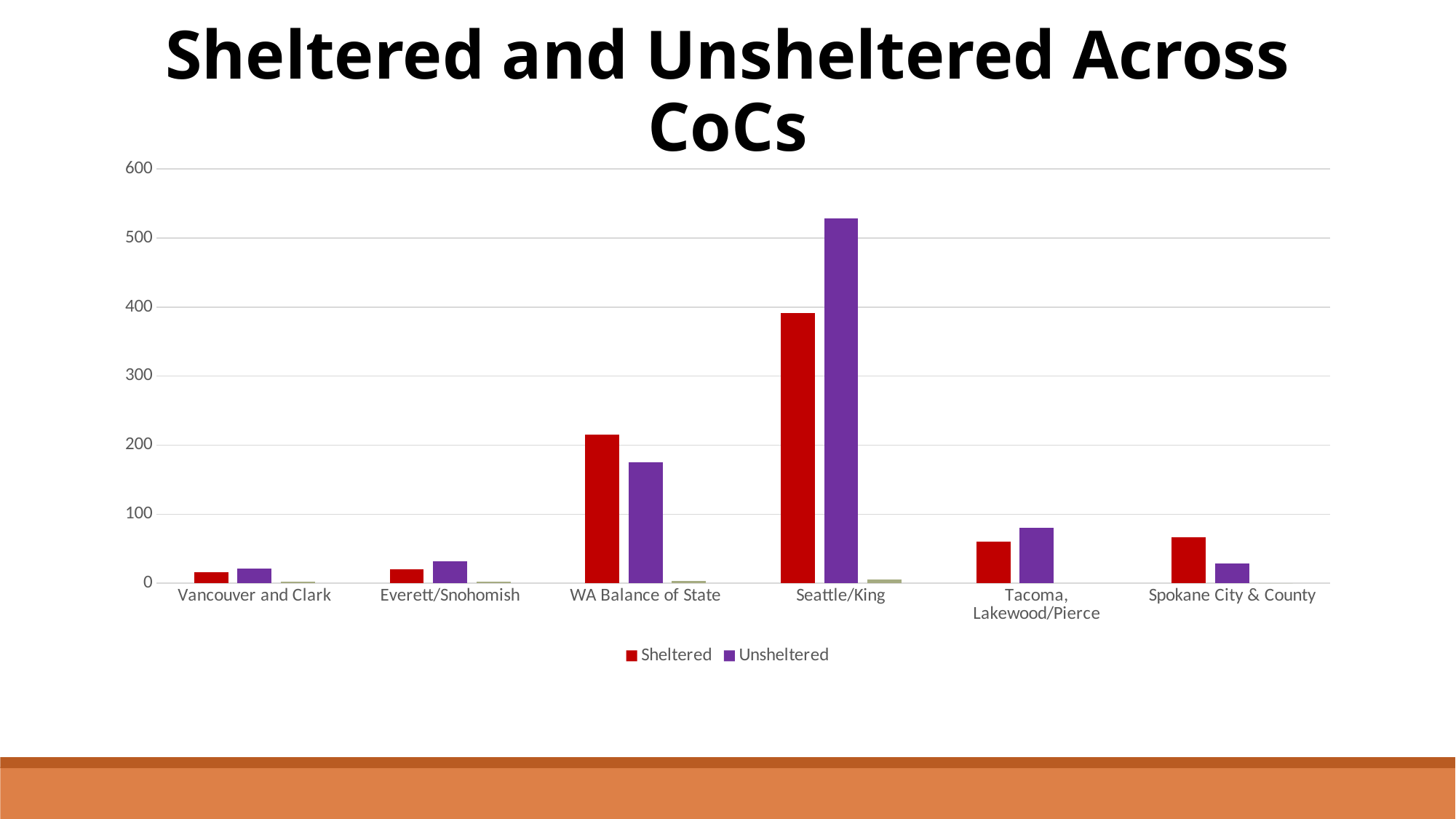
For WA Balance of State, which is larger: Sheltered or Unsheltered? Sheltered How many series does the legend list? 2 How many CoC categories are shown along the x axis? 6 Is the Unsheltered value for Tacoma, Lakewood/Pierce greater or less than 100? less Is the Unsheltered value for WA Balance of State greater or less than 200? less Which CoC has the highest Unsheltered value? Seattle/King Is the Sheltered value for Seattle/King greater or less than 300? greater For Spokane City & County, which is larger: Sheltered or Unsheltered? Sheltered Which CoC has the highest Sheltered value? Seattle/King What is the title of the chart? Sheltered and Unsheltered Across CoCs What kind of chart is shown on the slide? bar chart